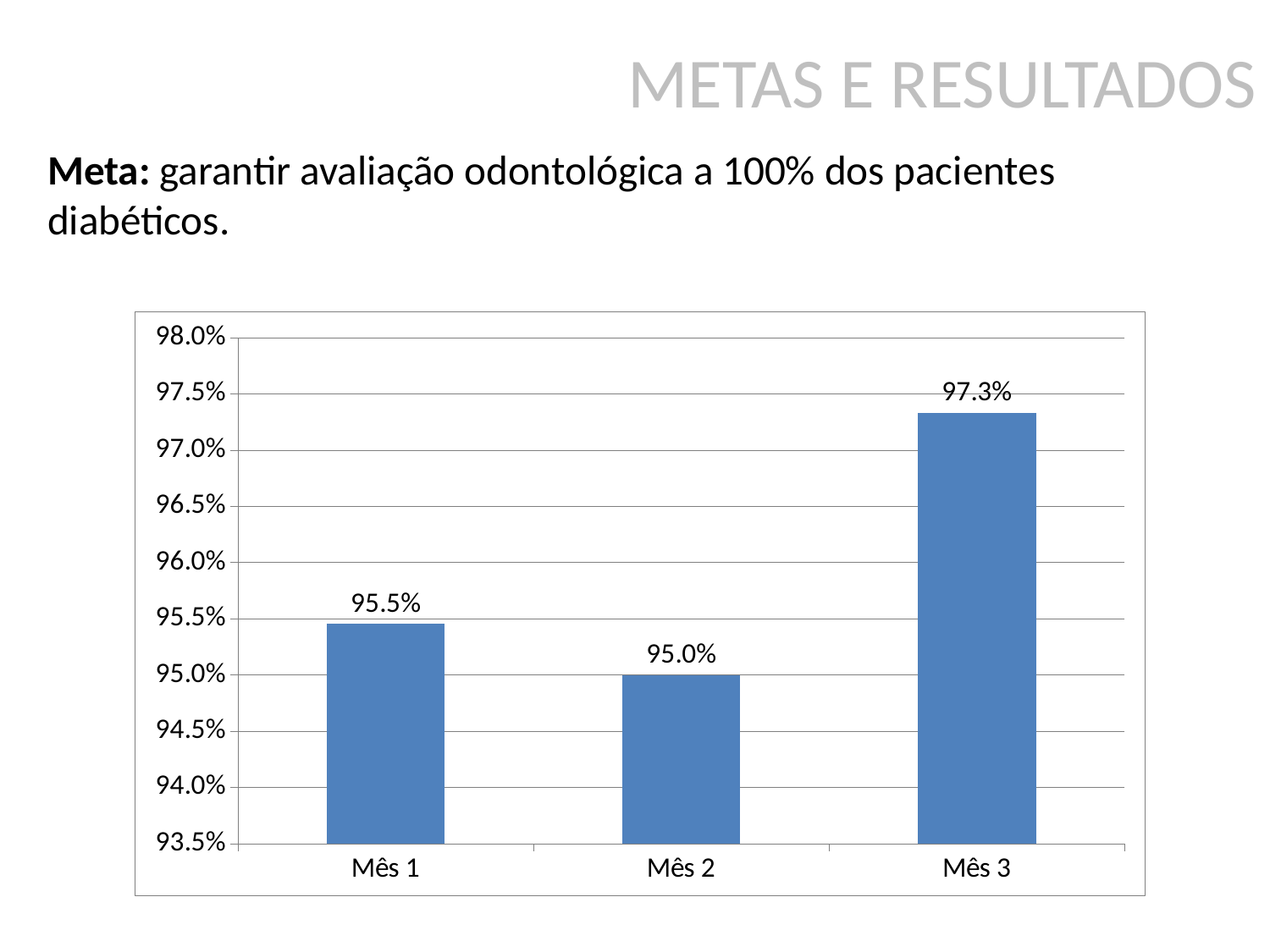
What is the value for Mês 3? 97.3% Which is larger, the value for Mês 1 or the value for Mês 3? Mês 3 What is the difference between the values for Mês 1 and Mês 2? 0.5% Which month has the highest value? Mês 3 What is the lowest value shown on the y axis? 93.5% How many months are shown on the x axis? 3 What is the value for Mês 1? 95.5% What is the value for Mês 2? 95.0% What kind of chart is shown on the slide? bar chart What is the difference between the values for Mês 3 and Mês 2? 2.3% Is the value for Mês 3 greater or less than 97.0%? greater Which month has the lowest value? Mês 2